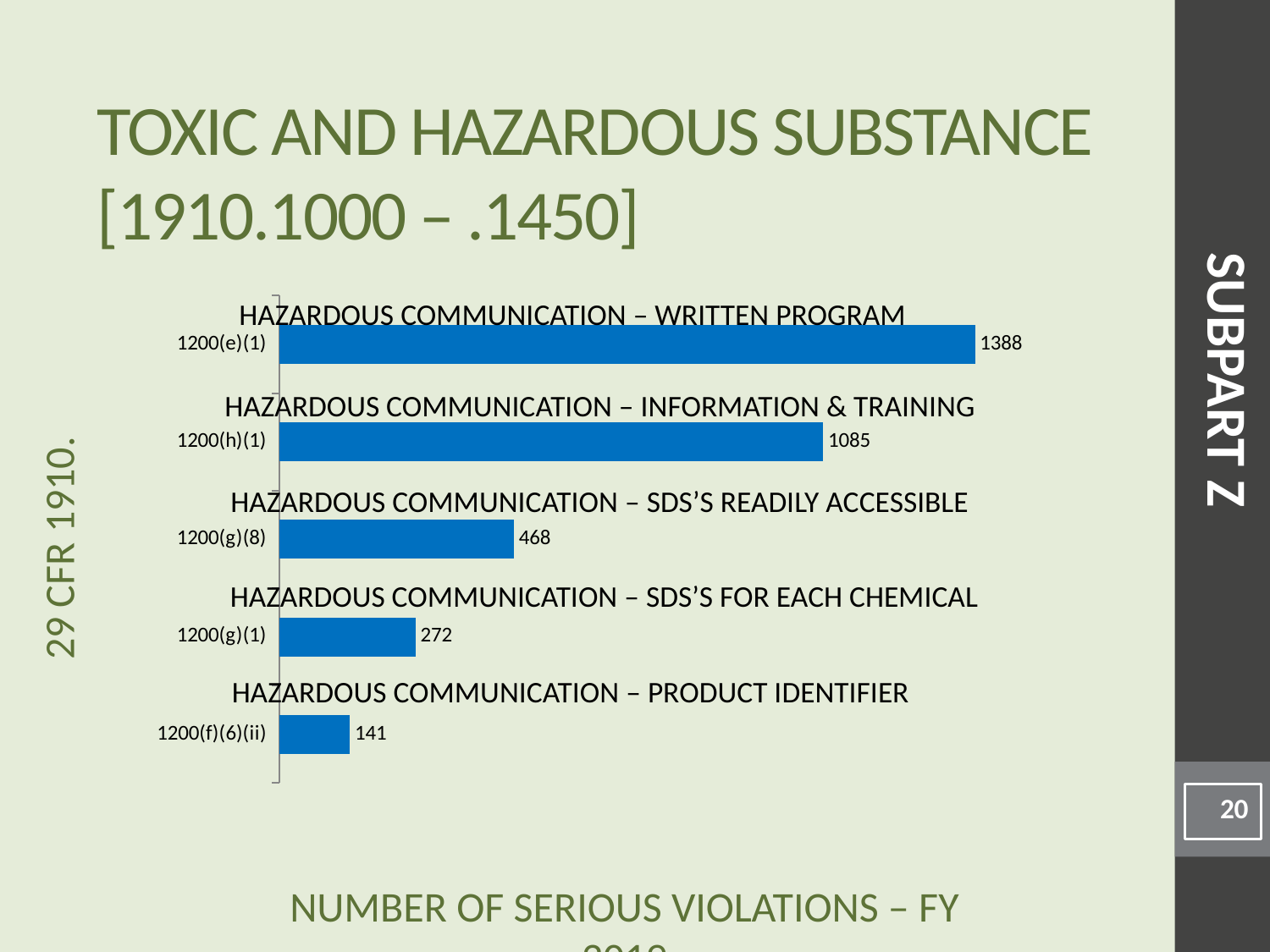
Which standard paragraph corresponds to Hazardous Communication – SDS's Readily Accessible? 1200(g)(8) Which category has the highest number of serious violations? 1200(e)(1) What is the number of serious violations for 1200(g)(8)? 468 What is the number of serious violations for 1200(e)(1)? 1388 What is the number of serious violations for 1200(f)(6)(ii)? 141 Which has more serious violations, 1200(g)(1) or 1200(f)(6)(ii)? 1200(g)(1) How many categories are shown in the chart? 5 What is the number of serious violations for 1200(h)(1)? 1085 Which category has the lowest number of serious violations? 1200(f)(6)(ii) What kind of chart is shown on the slide? Bar chart What is the difference between the values for 1200(g)(8) and 1200(g)(1)? 196 What is the difference between the values for 1200(e)(1) and 1200(h)(1)? 303